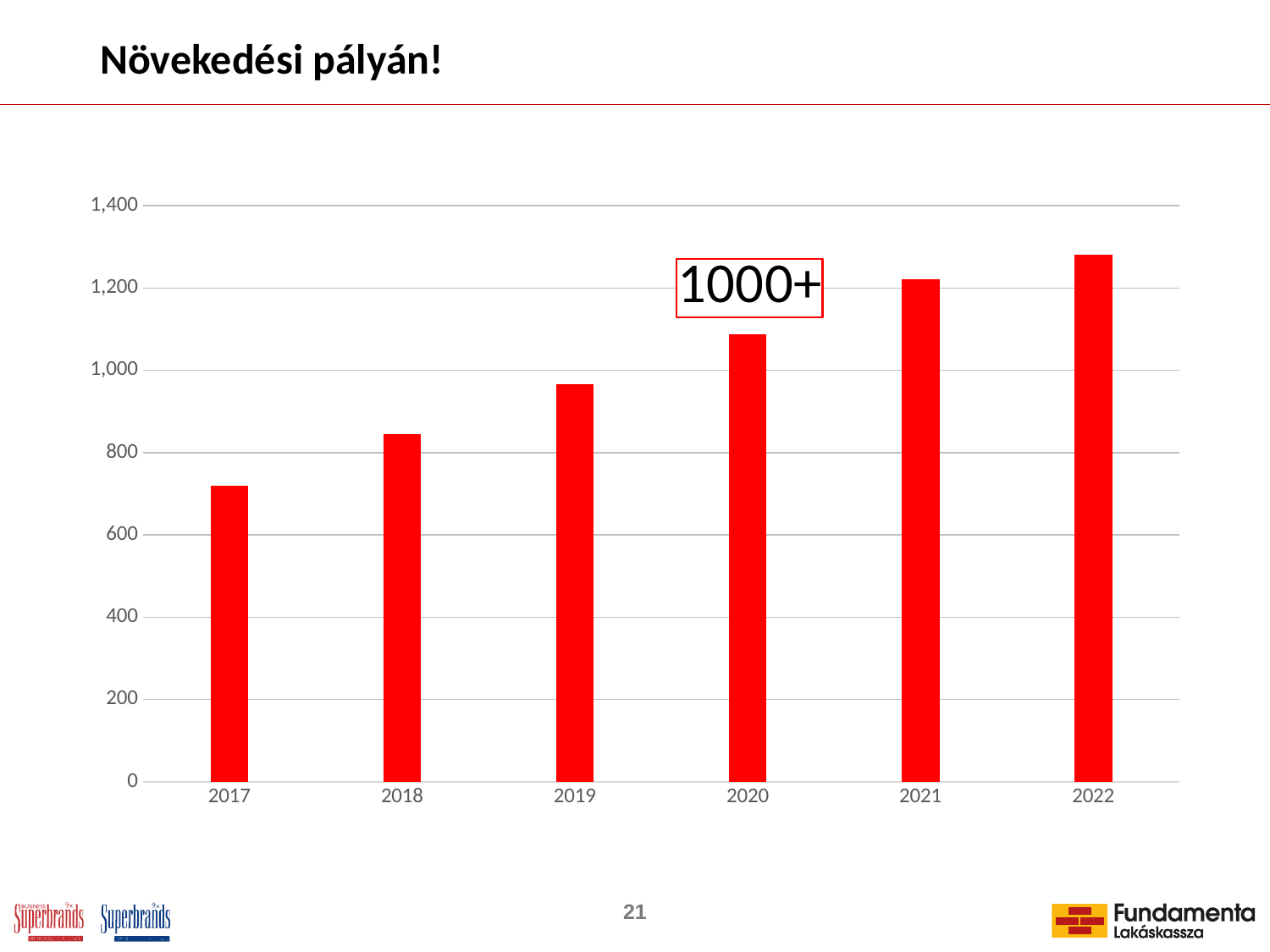
Which is larger, the value for 2018 or the value for 2020? 2020 How many years are shown on the x axis of the chart? 6 Is the value for 2021 greater or less than 1,200? greater What kind of chart is shown on the slide? bar chart What text is shown in the red-outlined box above the 2020 bar? 1000+ Do the values rise or fall from 2017 to 2022? rise Is the value for 2020 greater or less than 1,000? greater Is the value for 2019 greater or less than 1,000? less What is the title of the slide containing the chart? Növekedési pályán! Which year has the highest bar in the chart? 2022 Which year has the lowest bar in the chart? 2017